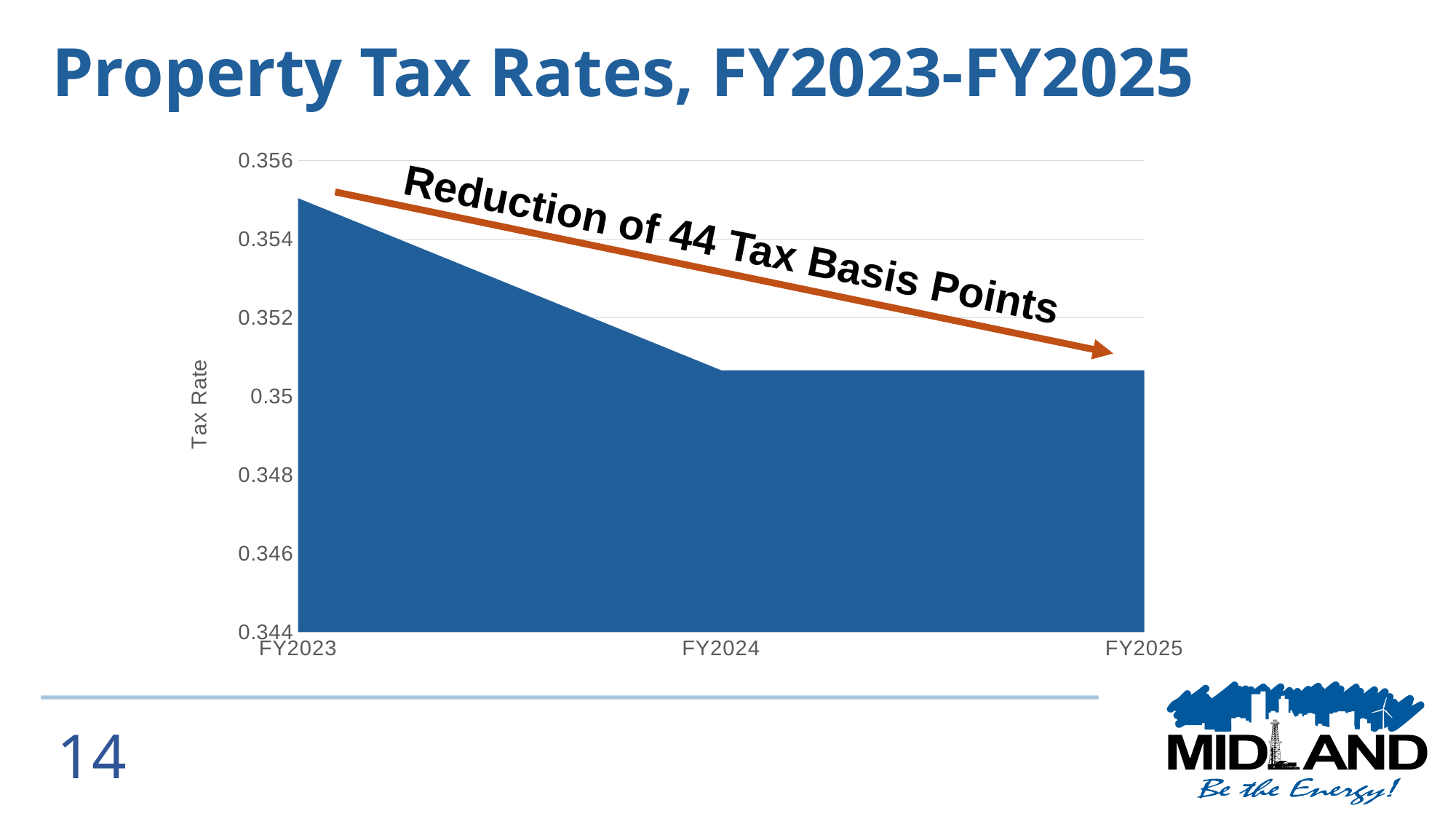
Is the tax rate for FY2025 greater or less than 0.352? less How many fiscal years are plotted on the x axis? 3 Which fiscal year has the highest tax rate? FY2023 Is the tax rate for FY2024 greater or less than 0.352? less Is the tax rate for FY2025 greater or less than 0.35? greater What is the title of the chart? Property Tax Rates, FY2023-FY2025 Which has the larger tax rate, FY2023 or FY2024? FY2023 What does the annotation arrow on the chart say? Reduction of 44 Tax Basis Points Does the tax rate rise or fall from FY2023 to FY2025? Fall What kind of chart is shown on the slide? Area chart